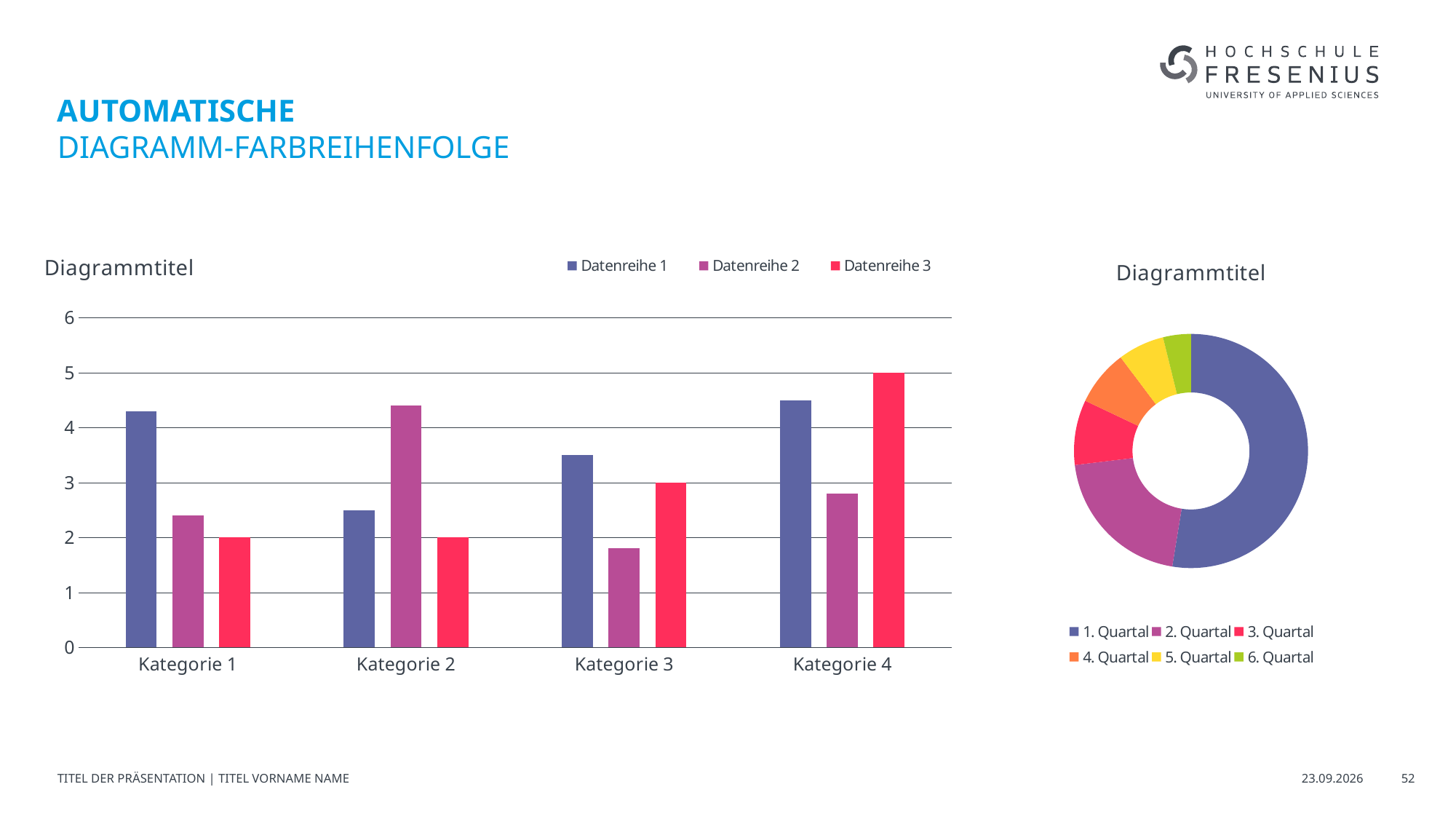
In the bar chart on the left, which category has the highest value for Datenreihe 3? Kategorie 4 In the bar chart on the left, is the value of Datenreihe 2 for Kategorie 3 greater or less than 2? less In the doughnut chart on the right, which quarter has the largest share? 1. Quartal What kind of chart is the chart on the right of the slide? doughnut chart In the bar chart on the left, is the value of Datenreihe 1 for Kategorie 1 greater or less than 4? greater In the bar chart on the left, for Kategorie 2, which series has the larger value: Datenreihe 1 or Datenreihe 2? Datenreihe 2 In the bar chart on the left, how many series does the legend list? 3 In the bar chart on the left, how many categories are shown on the x axis? 4 In the bar chart on the left, what is the value of Datenreihe 3 for Kategorie 4? 5 In the doughnut chart on the right, how many entries does the legend list? 6 What kind of chart is the chart on the left of the slide? bar chart In the bar chart on the left, what is the value of Datenreihe 3 for Kategorie 3? 3